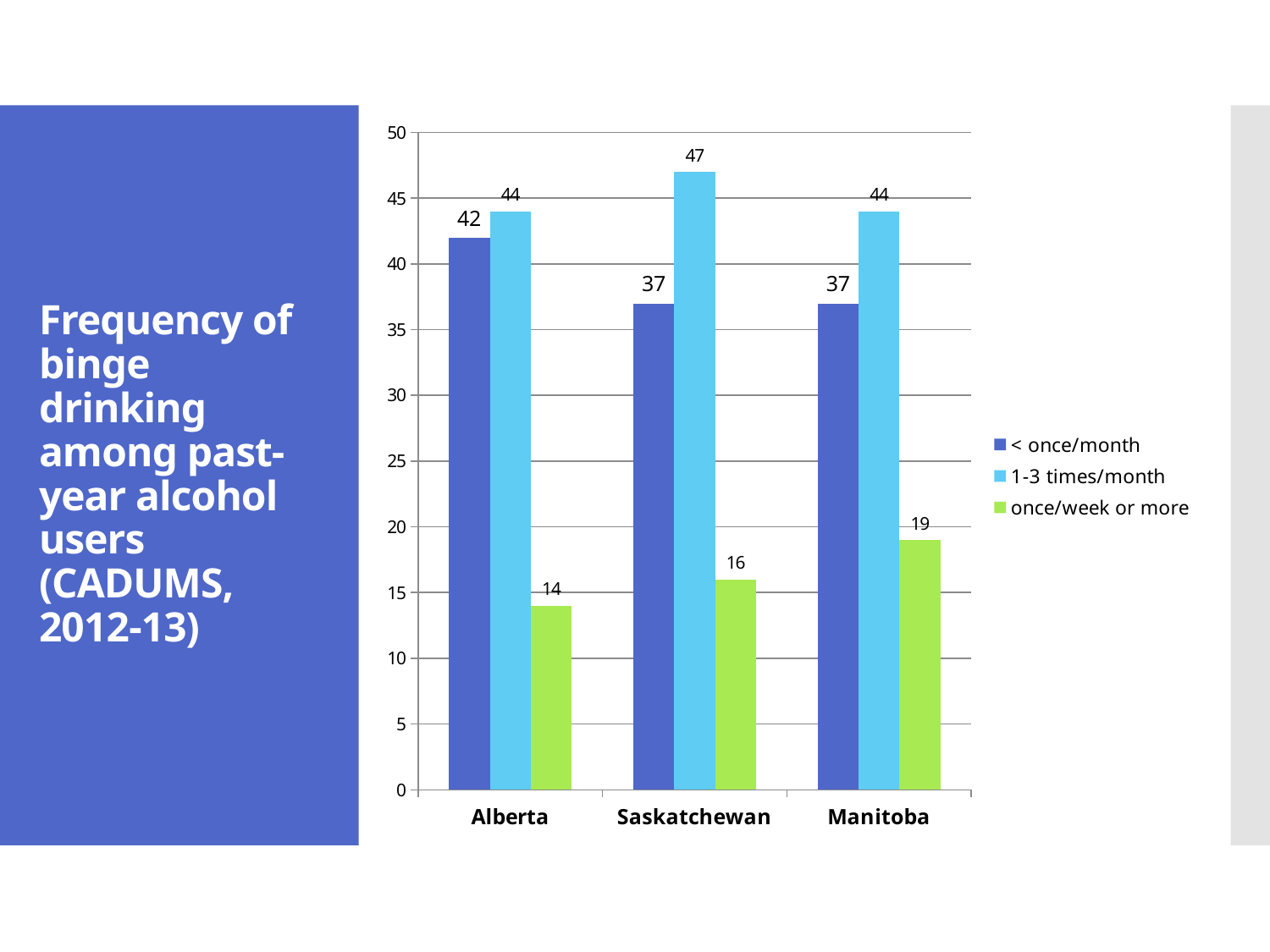
What kind of chart is shown on the slide? bar chart What is the value for '< once/month' in Alberta? 42 Which series is shown in green in the legend? once/week or more Which is larger in Manitoba: '< once/month' or '1-3 times/month'? 1-3 times/month Which province has the lowest value for 'once/week or more'? Alberta What is the value for '1-3 times/month' in Saskatchewan? 47 Which province has the highest value for '1-3 times/month'? Saskatchewan What is the value for 'once/week or more' in Manitoba? 19 What is the difference between the '1-3 times/month' and '< once/month' values in Saskatchewan? 10 Is the value for 'once/week or more' in Saskatchewan greater or less than 20? less How many provinces are shown on the x axis? 3 How many series does the legend list? 3